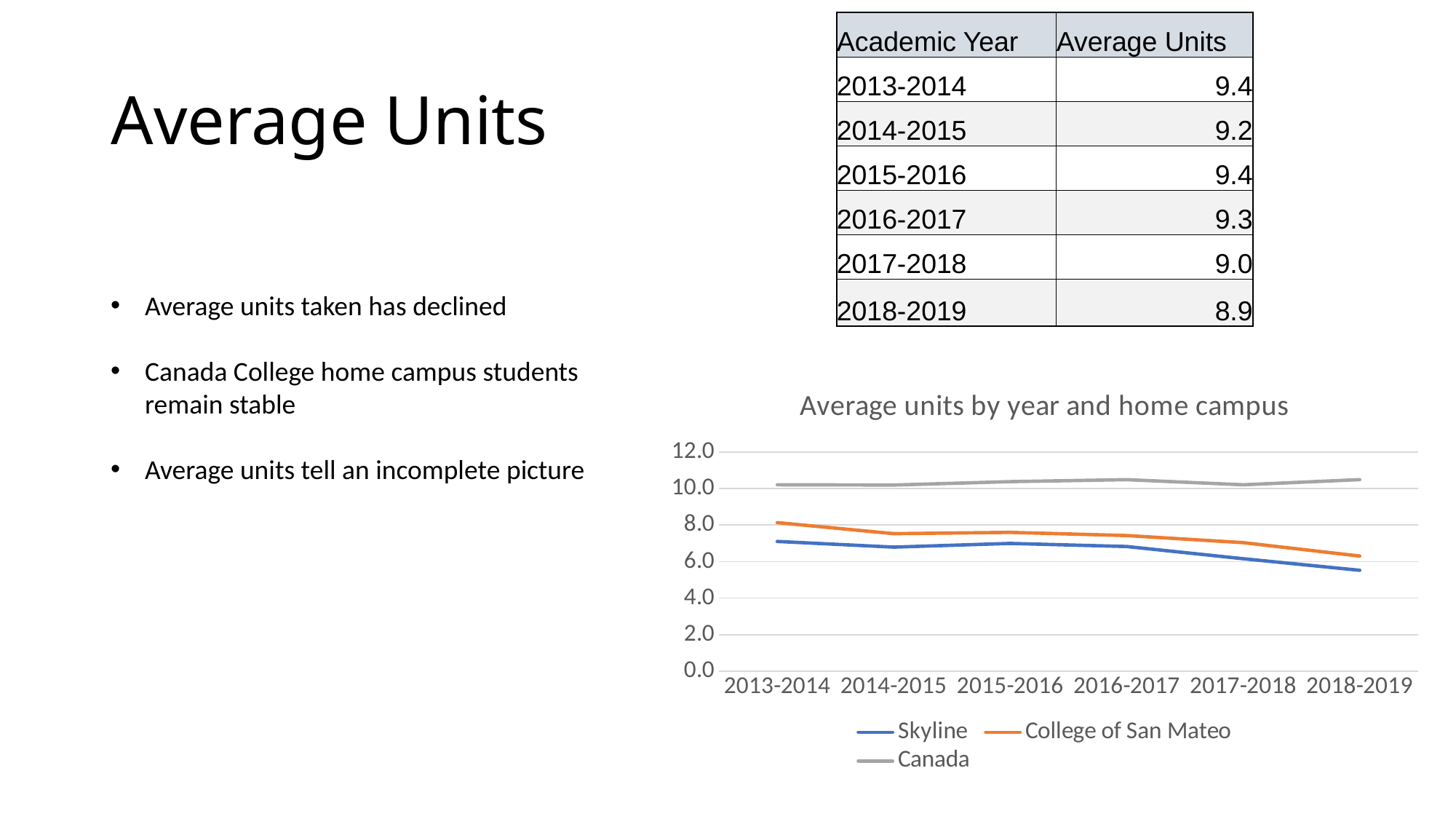
Is the value for Skyline in 2018-2019 greater or less than 6.0? less Which home campus has the lowest average units in 2018-2019? Skyline How many academic years are shown on the x axis of the chart? 6 Is the value for Skyline in 2013-2014 greater or less than 6.0? greater Is the value for Canada in 2018-2019 greater or less than 10.0? greater What kind of chart is shown on the slide? line chart Do the values for Skyline rise or fall from 2013-2014 to 2018-2019? fall What is the title of the chart? Average units by year and home campus In 2013-2014, which is larger: the value for College of San Mateo or the value for Skyline? College of San Mateo How many series does the chart's legend list? 3 What colour is the line for Canada in the chart? gray Which home campus has the highest average units in 2018-2019? Canada